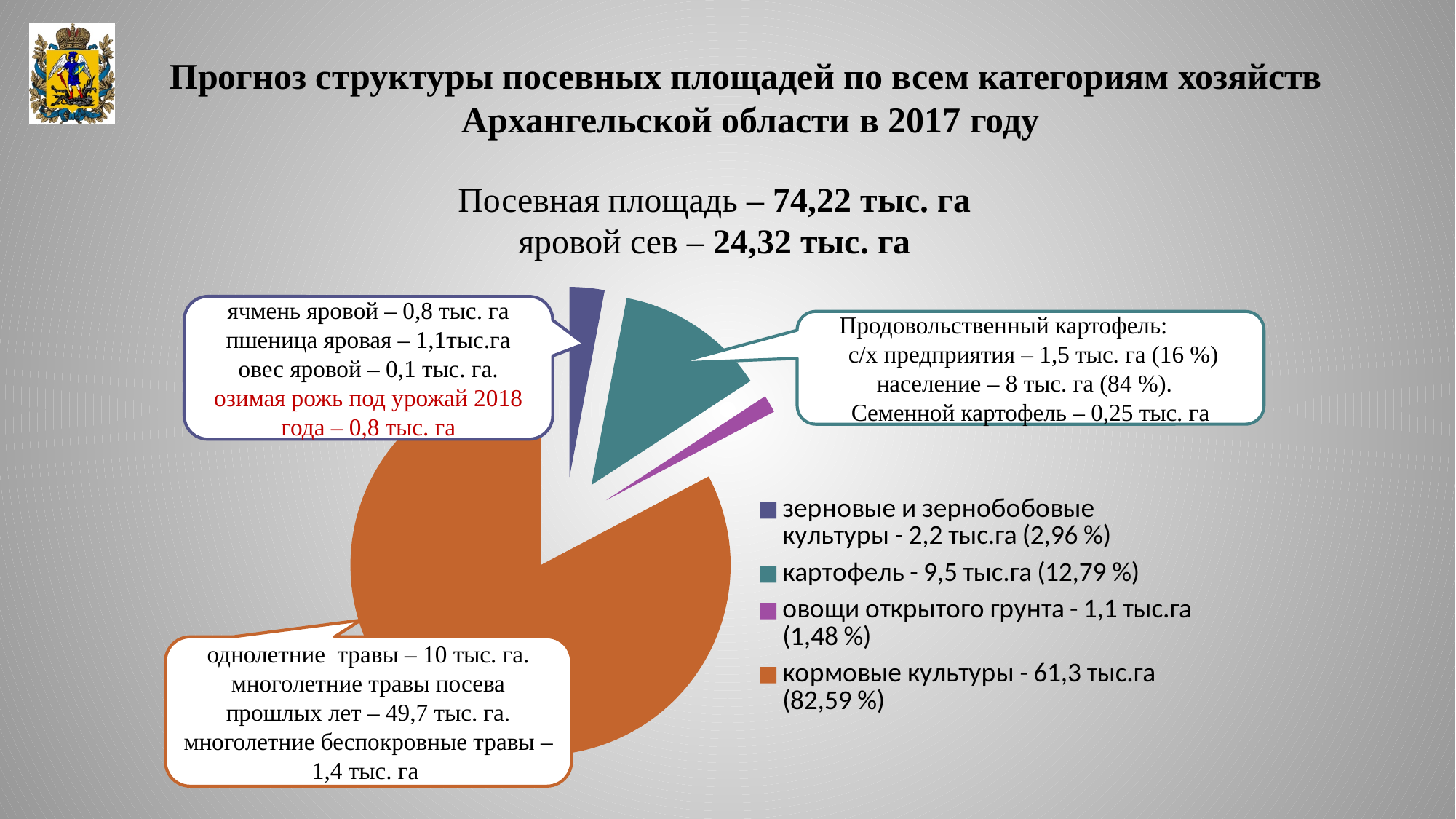
What is the value shown for картофель in the legend? 9,5 тыс.га What share of the pie does овощи открытого грунта represent? 1,48 % What kind of chart is shown on the slide? pie chart Which category has the smallest slice of the pie chart? овощи открытого грунта What is the value shown for зерновые и зернобобовые культуры in the legend? 2,2 тыс.га What share of the pie does кормовые культуры represent? 82,59 % What is the difference in тыс.га between картофель and зерновые и зернобобовые культуры? 7,3 тыс.га What colour is the slice for картофель in the pie chart? teal Which is larger, the value for картофель or the value for овощи открытого грунта? картофель How many slices does the pie chart have? 4 How many entries does the legend of the pie chart list? 4 Which category has the largest slice of the pie chart? кормовые культуры